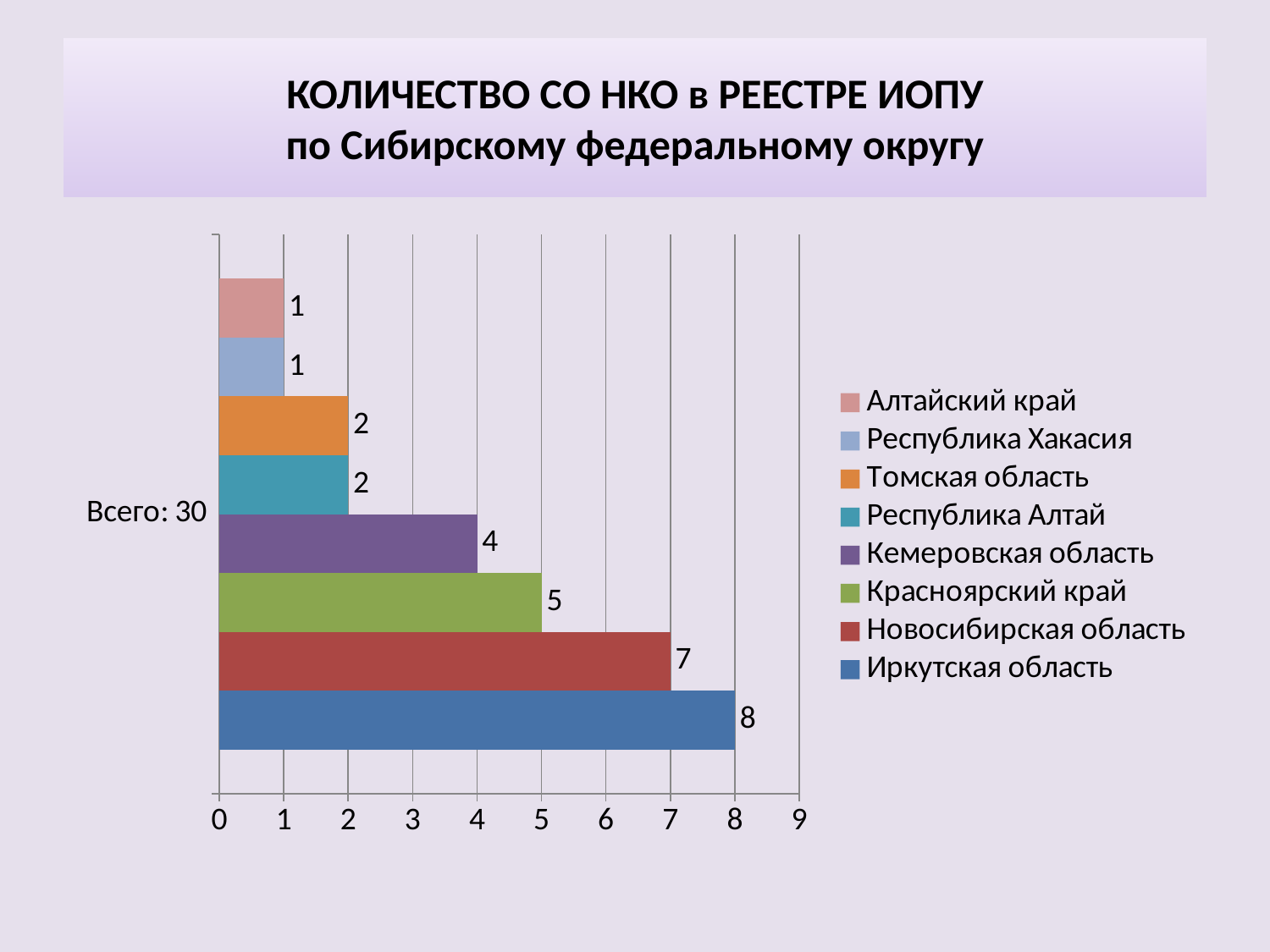
What is the category label shown on the vertical axis of the chart? Всего: 30 What type of chart is shown on the slide? bar chart What is the value for Иркутская область? 8 What is the value for Новосибирская область? 7 What is the title of the chart? КОЛИЧЕСТВО СО НКО в РЕЕСТРЕ ИОПУ по Сибирскому федеральному округу Which is larger, the value for Новосибирская область or the value for Кемеровская область? Новосибирская область What is the total of all the values shown in the chart? 30 How many series does the legend list? 8 What is the difference between the values for Иркутская область and Красноярский край? 3 What is the value for Кемеровская область? 4 Which region has the highest value? Иркутская область What is the value for Томская область? 2